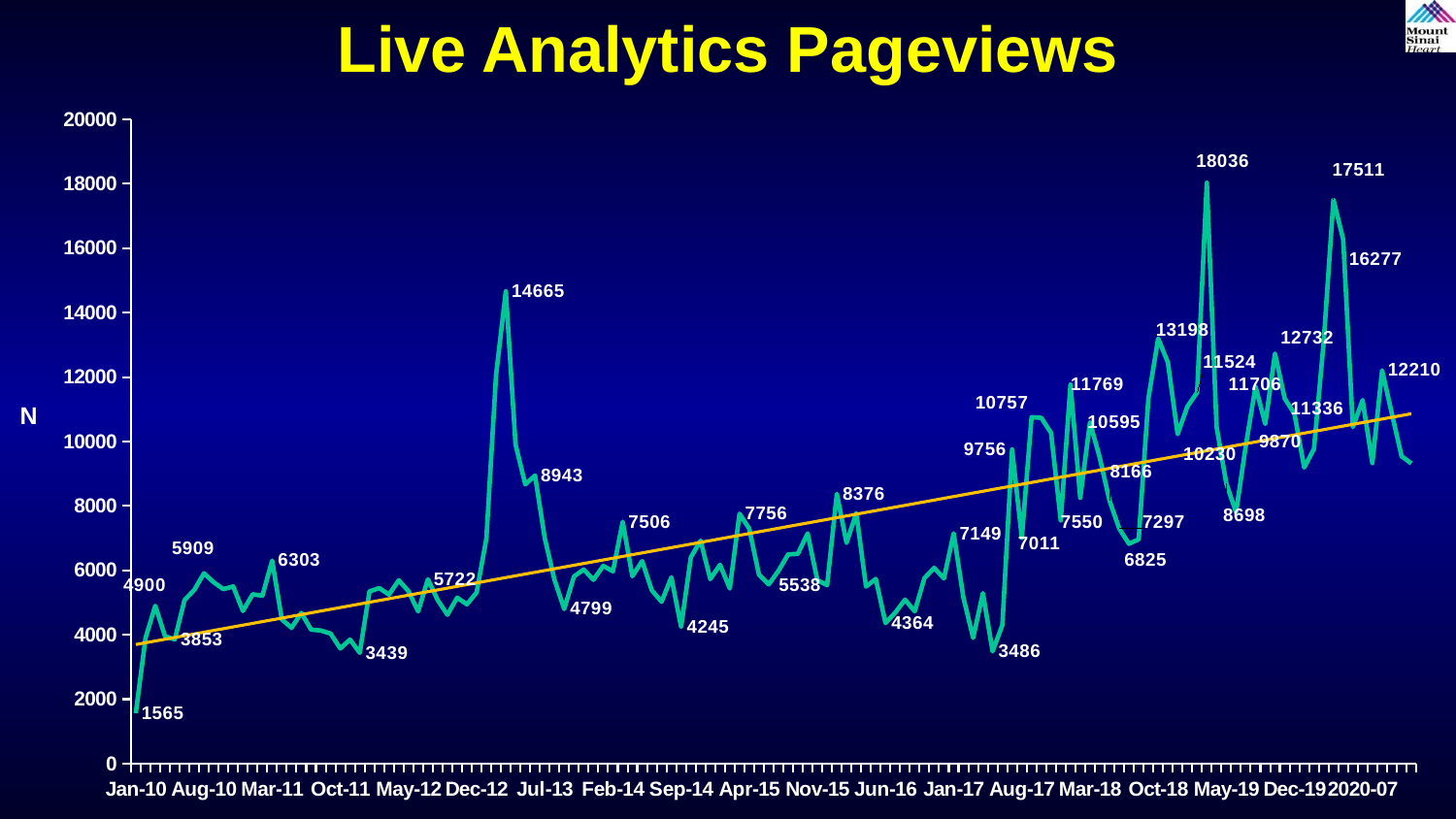
Do the pageview values generally rise or fall from Jan-10 to 2020-07? rise What is the highest labeled value on the chart? 18036 What is the lowest labeled value on the chart? 1565 Is the labeled value 3486 greater or less than 4000? less What is the title of the chart? Live Analytics Pageviews What is the difference between the two highest labeled peaks, 18036 and 17511? 525 What is the value of the first data point, at Jan-10? 1565 Is the value at the final data point (2020-07) greater or less than 8000? greater What is the difference between the labeled values 14665 and 8943? 5722 What kind of chart is shown on the slide? line chart Which is larger, the labeled peak of 14665 or the labeled peak of 17511? 17511 What is the label on the vertical axis? N